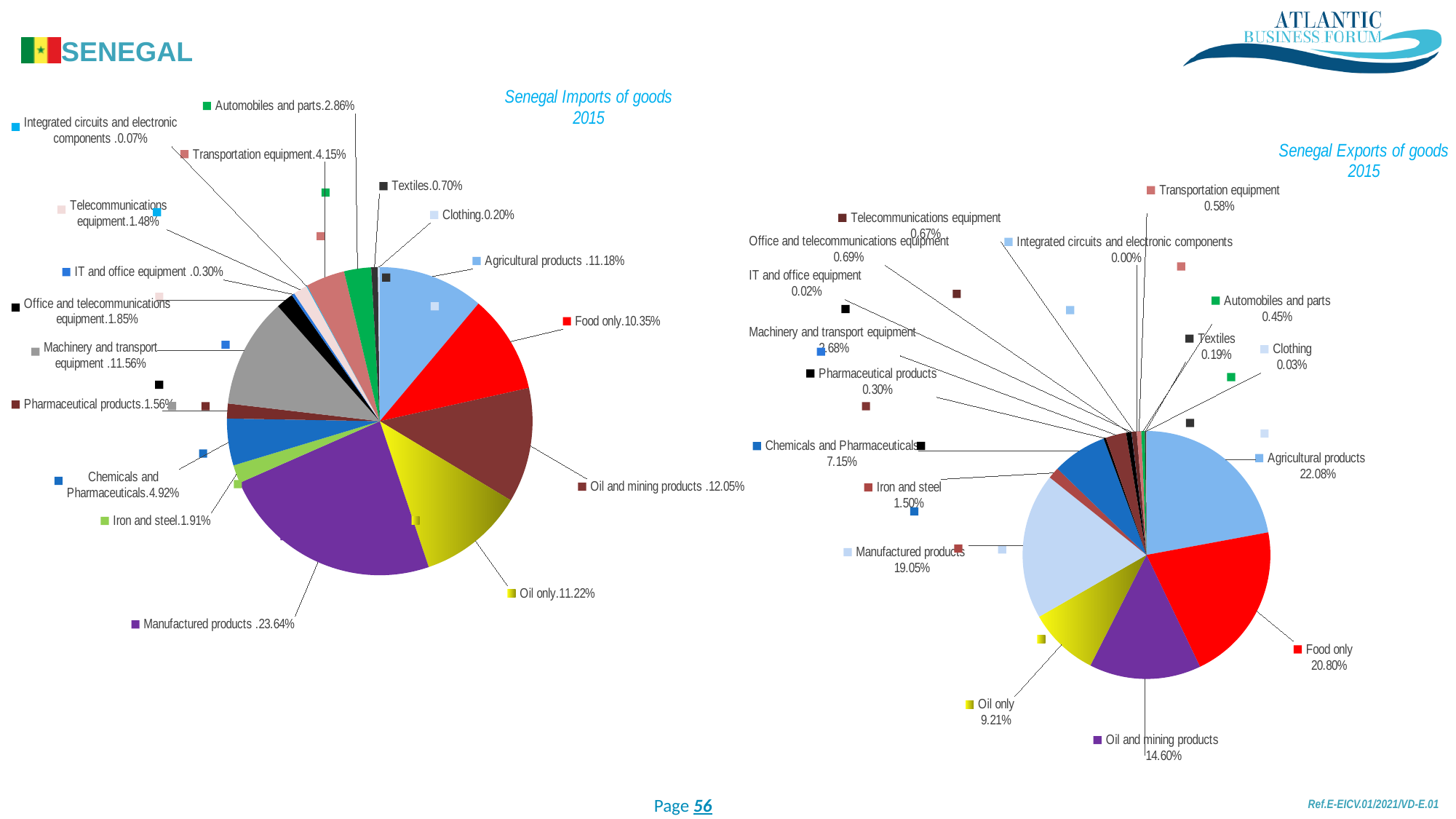
How many categories are shown in the 'Senegal Exports of goods 2015' chart? 17 In the 'Senegal Exports of goods 2015' chart, what is the difference between the shares of Manufactured products and Oil and mining products? 4.45% In the 'Senegal Imports of goods 2015' chart, which category has the smallest share? Integrated circuits and electronic components In the 'Senegal Imports of goods 2015' chart, what share do Oil and mining products have? 12.05% In the 'Senegal Imports of goods 2015' chart, what is the difference between the shares of Manufactured products and Agricultural products? 12.46% In the 'Senegal Exports of goods 2015' chart, what share do Agricultural products have? 22.08% In the 'Senegal Imports of goods 2015' chart, what share do Manufactured products have? 23.64% In the 'Senegal Imports of goods 2015' chart, which is larger: Food only or Oil only? Oil only In the 'Senegal Imports of goods 2015' chart, which category has the largest share? Manufactured products What kind of chart is the 'Senegal Imports of goods 2015' chart? pie chart In the 'Senegal Exports of goods 2015' chart, what share does Food only have? 20.80% In the 'Senegal Exports of goods 2015' chart, which category has the largest share? Agricultural products